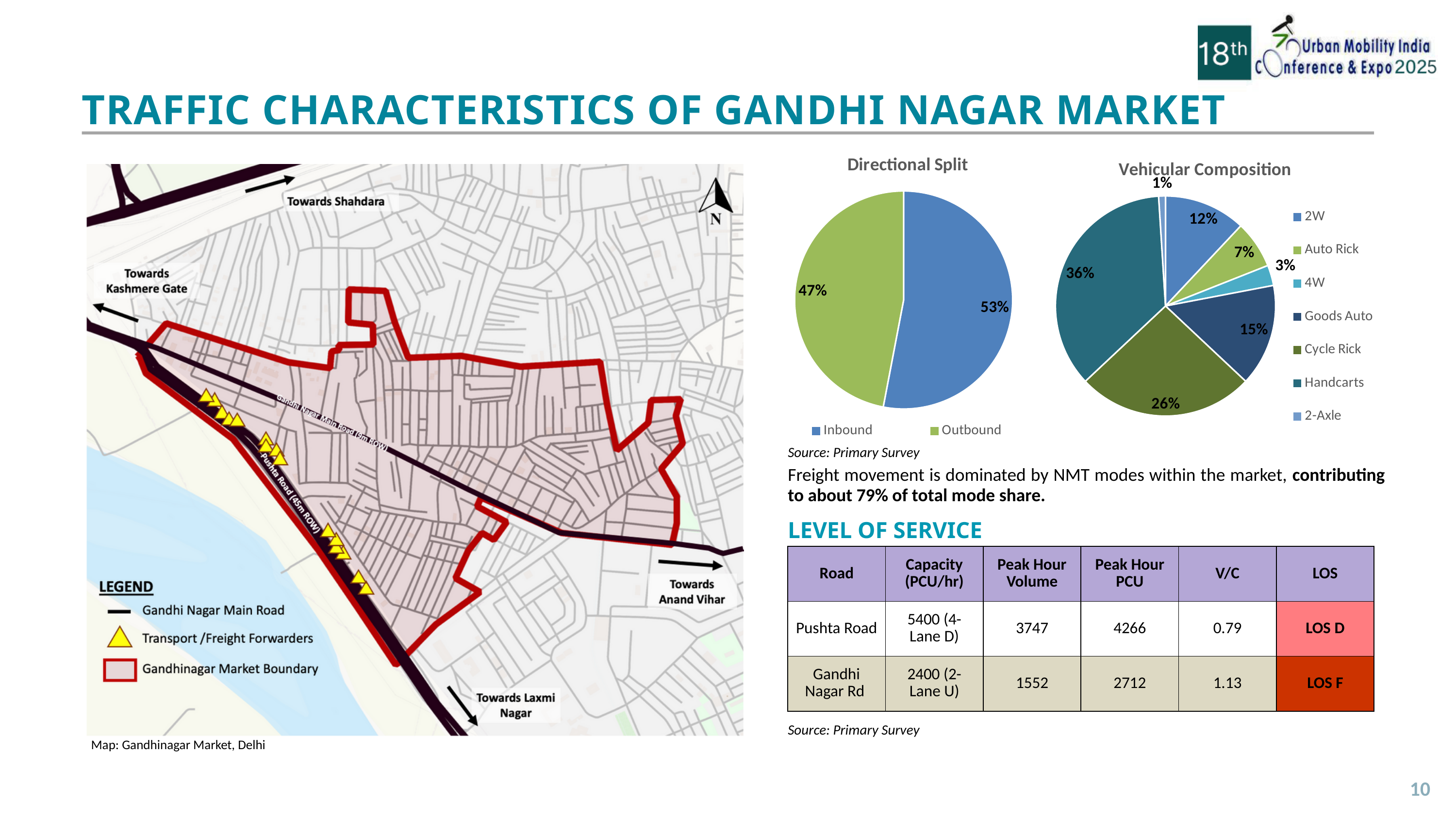
How many vehicle types does the legend of the Vehicular Composition chart list? 7 What kind of chart is the Directional Split chart? Pie chart In the Vehicular Composition chart, what is the difference between the shares of 2W and Auto Rick? 5% In the Vehicular Composition chart, which vehicle type has the largest share? Handcarts In the Directional Split chart, what percentage of traffic is Inbound? 53% In the Vehicular Composition chart, what is the share of Handcarts? 36% In the Directional Split chart, which direction has the larger share, Inbound or Outbound? Inbound In the Vehicular Composition chart, what is the share of Goods Auto? 15% In the Directional Split chart, what percentage of traffic is Outbound? 47% In the Vehicular Composition chart, which vehicle type has the smallest share? 2-Axle In the Directional Split chart, what is the difference between the Inbound and Outbound shares? 6% In the Vehicular Composition chart, what is the share of Cycle Rick? 26%